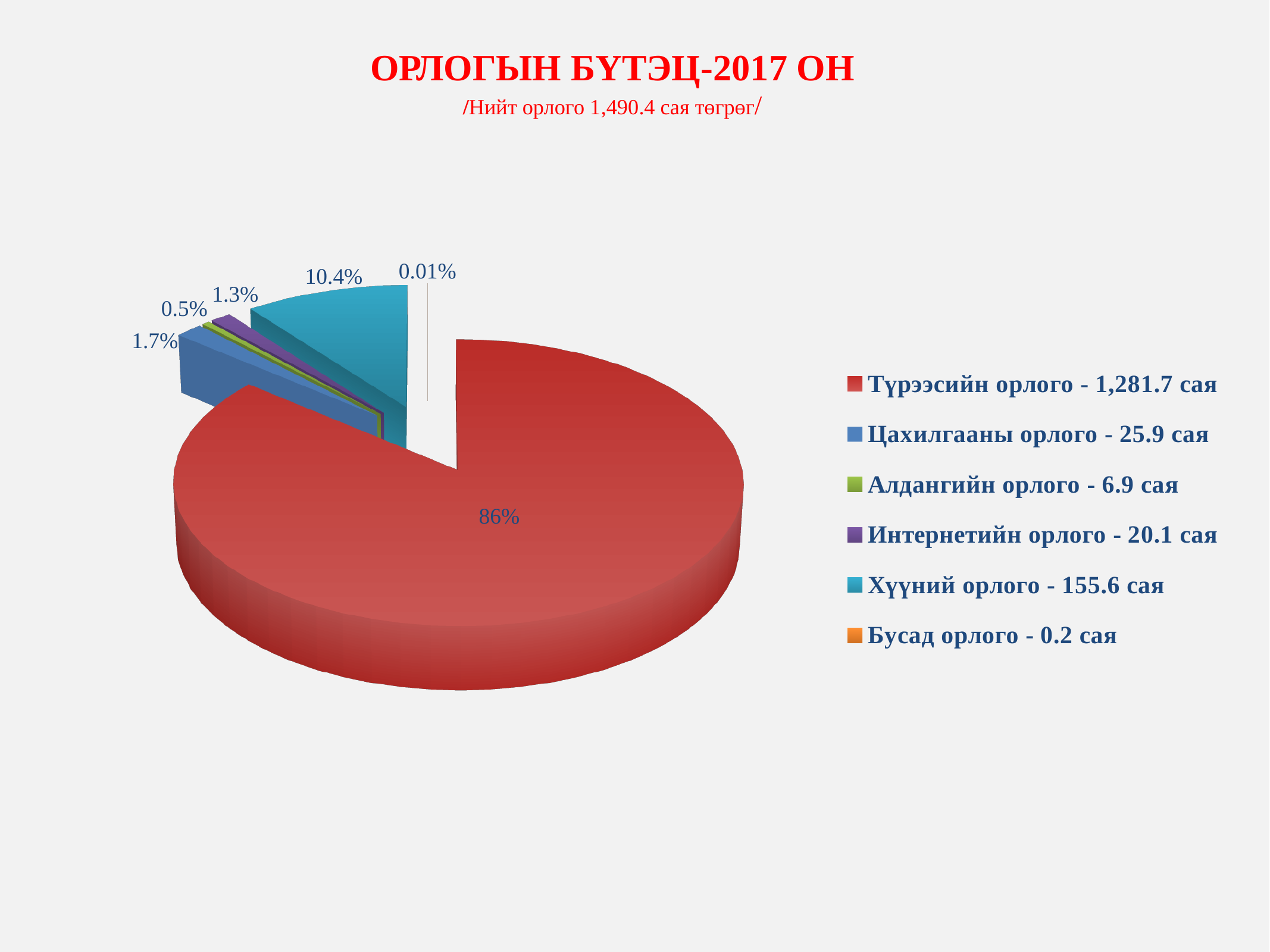
What share of the pie does Интернетийн орлого take? 1.3% What share of the pie does Түрээсийн орлого take? 86% What share of the pie does Хүүний орлого take? 10.4% According to the legend, what is the value for Хүүний орлого? 155.6 сая Which category has the smallest slice of the pie? Бусад орлого Which is larger, the share for Цахилгааны орлого or the share for Интернетийн орлого? Цахилгааны орлого Which category has the largest slice of the pie? Түрээсийн орлого What kind of chart is shown on the slide? pie chart What is the difference in percentage points between the share for Түрээсийн орлого and the share for Хүүний орлого? 75.6 How many categories does the legend of the pie chart list? 6